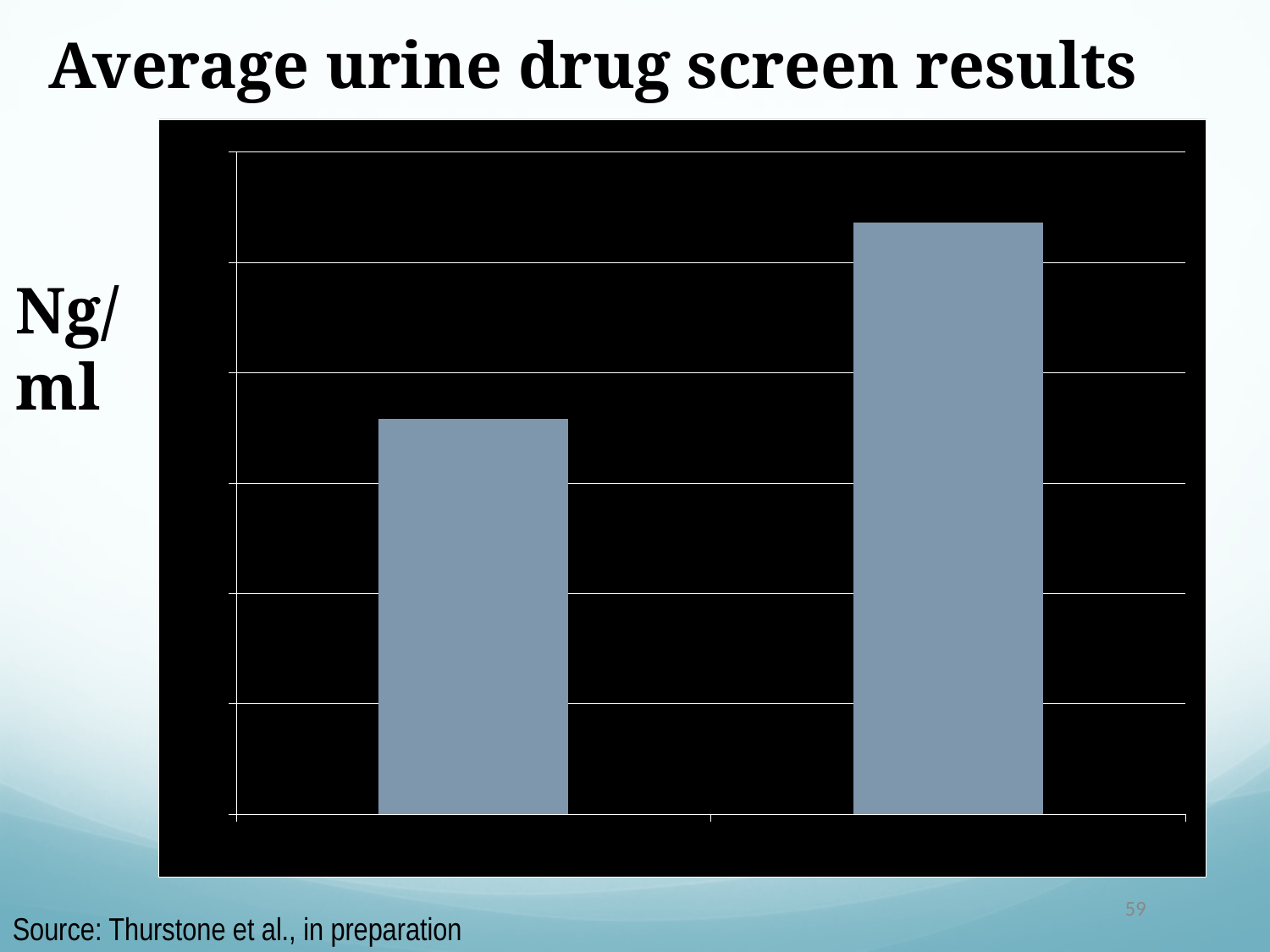
Which bar shows the highest value? the right bar What unit is shown as the vertical axis label of the chart? Ng/ml Which bar is taller, the left bar or the right bar? the right bar What kind of chart is shown on the slide? bar chart Which bar shows the lowest value? the left bar How many bars are plotted in the chart? 2 What is the title of the chart? Average urine drug screen results Do the bar values rise or fall from left to right? rise